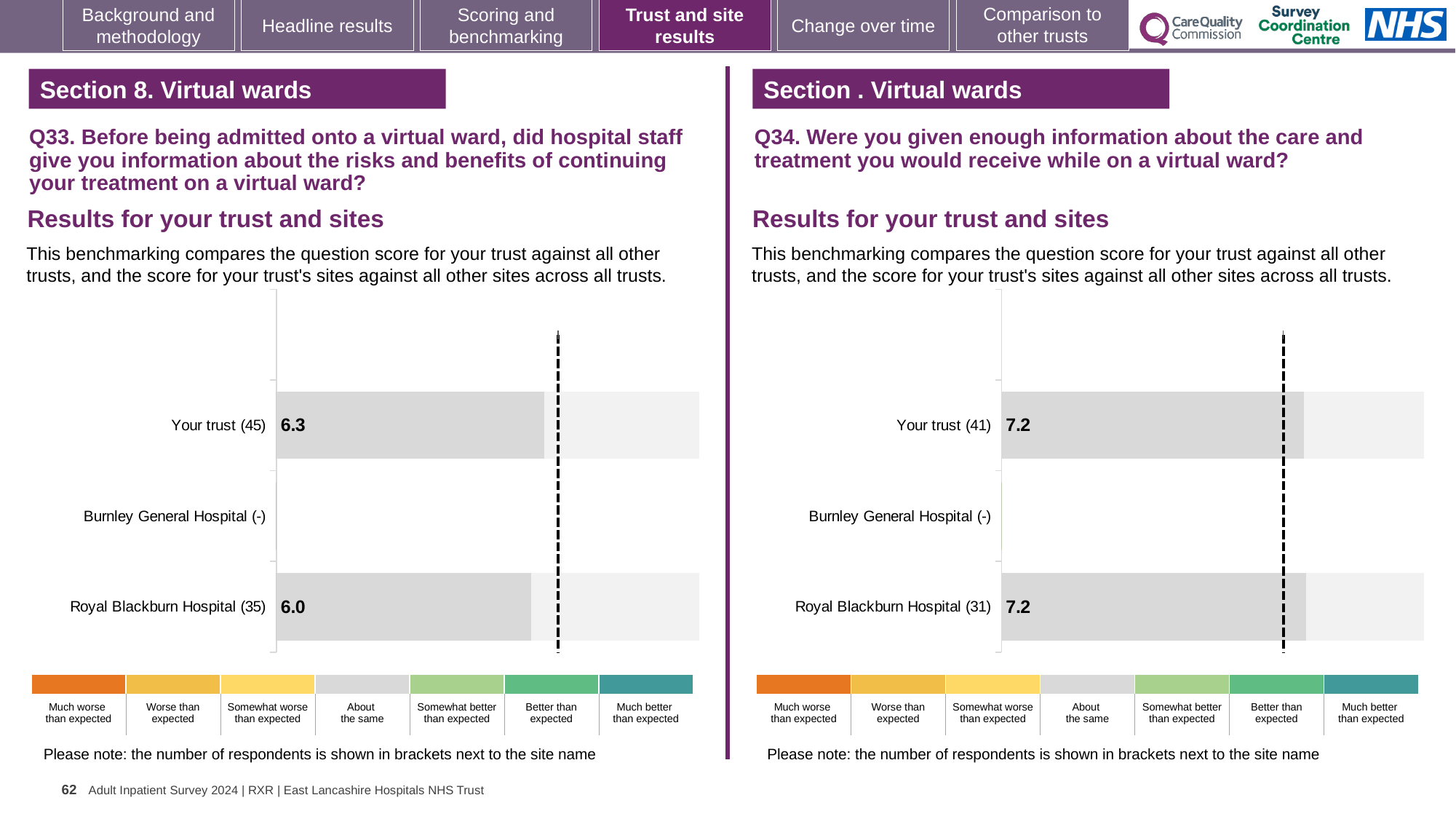
In the Q33 chart on the left, how many respondents are shown in brackets for Your trust? 45 In the Q34 chart on the right, which category has no score shown? Burnley General Hospital In the Q34 chart on the right, what is the score for Your trust? 7.2 In the Q33 chart on the left, what is the score for Your trust? 6.3 How many site/trust categories are listed on the Q34 chart on the right? 3 In the Q33 chart on the left, which labelled bar has the highest score? Your trust In the Q33 chart on the left, which has the higher score, Your trust or Royal Blackburn Hospital? Your trust In the Q33 chart on the left, what is the difference between the score for Your trust and the score for Royal Blackburn Hospital? 0.3 In the Q34 chart on the right, what is the score for Royal Blackburn Hospital? 7.2 In the Q33 chart on the left, what is the score for Royal Blackburn Hospital? 6.0 In the Q34 chart on the right, how many respondents are shown in brackets for Royal Blackburn Hospital? 31 What kind of chart is used for the Q33 results on the left? Bar chart